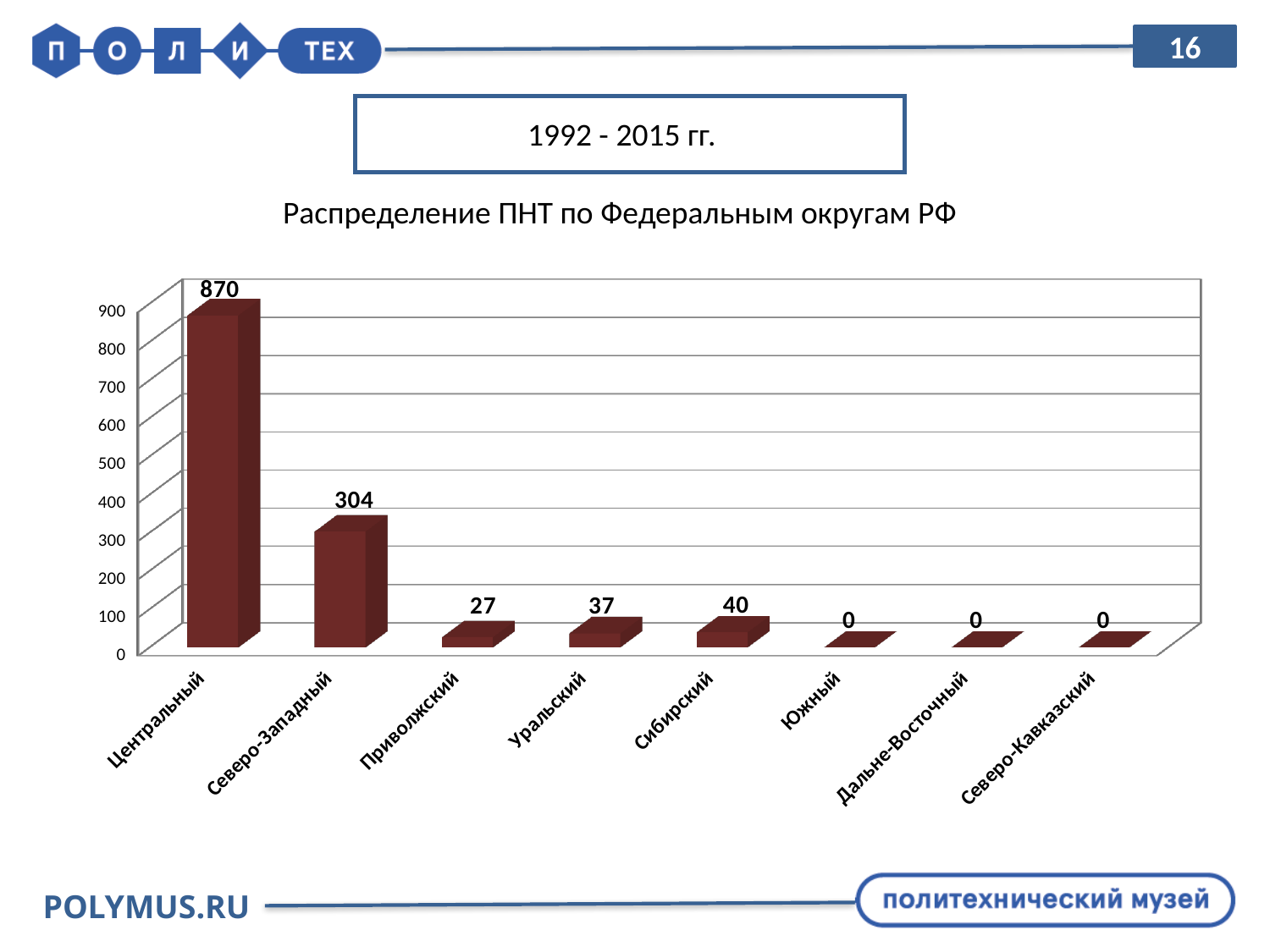
Which is larger, the value for Уральский or the value for Сибирский? Сибирский How many federal districts are shown on the x axis? 8 How many districts have a value of 0? 3 What is the difference between the values for Центральный and Северо-Западный? 566 What is the value for Приволжский? 27 What is the value for Северо-Западный? 304 What is the value for Центральный? 870 What is the value for Сибирский? 40 What kind of chart is shown on the slide? bar chart Which federal district has the highest value? Центральный What is the title of the chart? Распределение ПНТ по Федеральным округам РФ